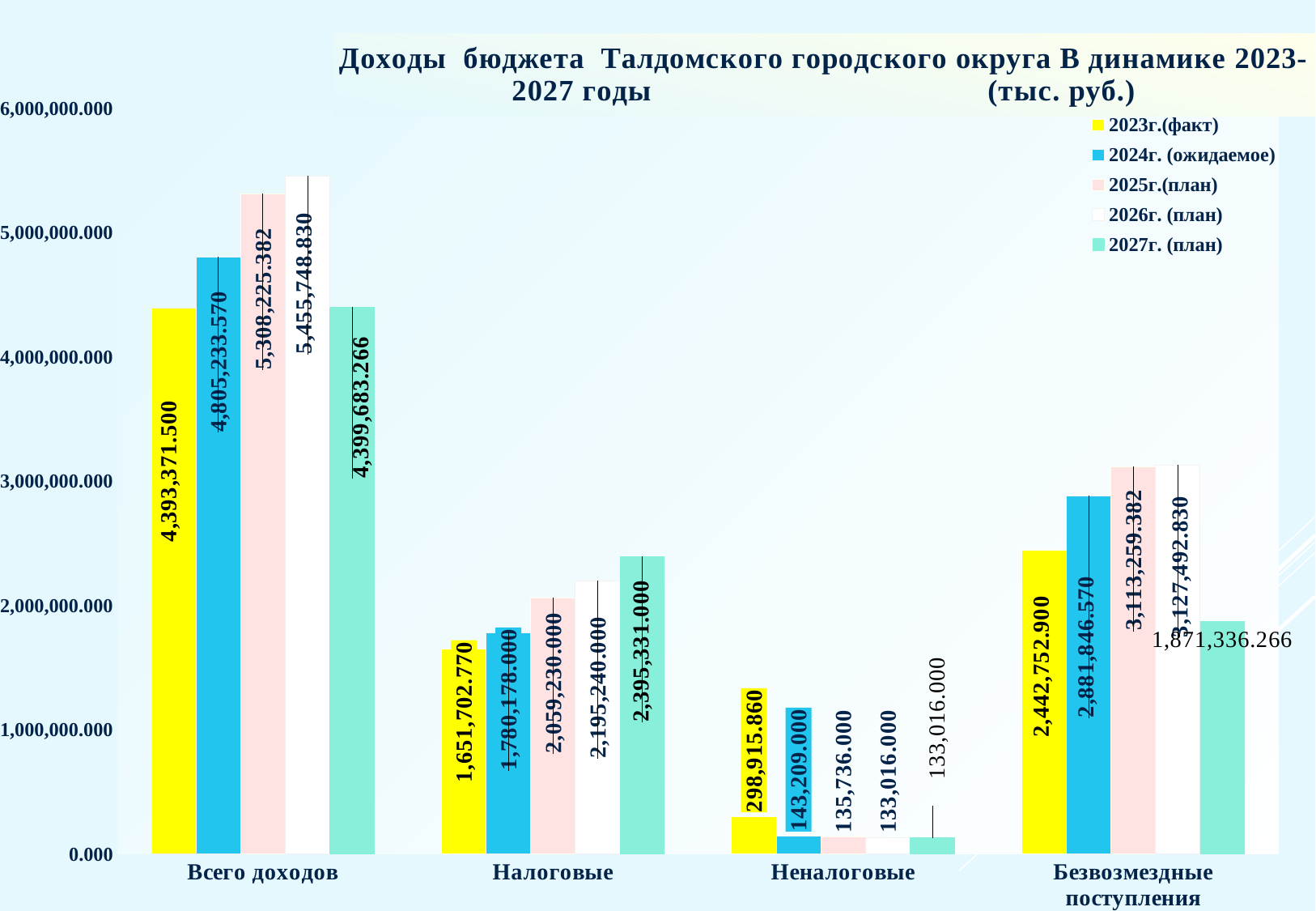
What is the value for 2025г.(план) in the Безвозмездные поступления category? 3,113,259.382 Which year has the highest value in the Неналоговые category? 2023г.(факт) Do the values in the Налоговые category rise or fall from 2023 to 2027? rise In the Всего доходов category, which is larger: the 2024г. (ожидаемое) value or the 2027г. (план) value? 2024г. (ожидаемое) Which year has the lowest value in the Безвозмездные поступления category? 2027г. (план) How many categories are shown on the x axis? 4 What is the value for 2027г. (план) in the Налоговые category? 2,395,331.000 How many series does the legend list? 5 Is the 2027г. (план) value for Безвозмездные поступления greater or less than 2,000,000.000? less Which year has the highest value in the Всего доходов category? 2026г. (план) What is the difference between the 2027г. (план) and 2023г.(факт) values in the Налоговые category? 743,628.230 What is the value for 2023г.(факт) in the Всего доходов category? 4,393,371.500